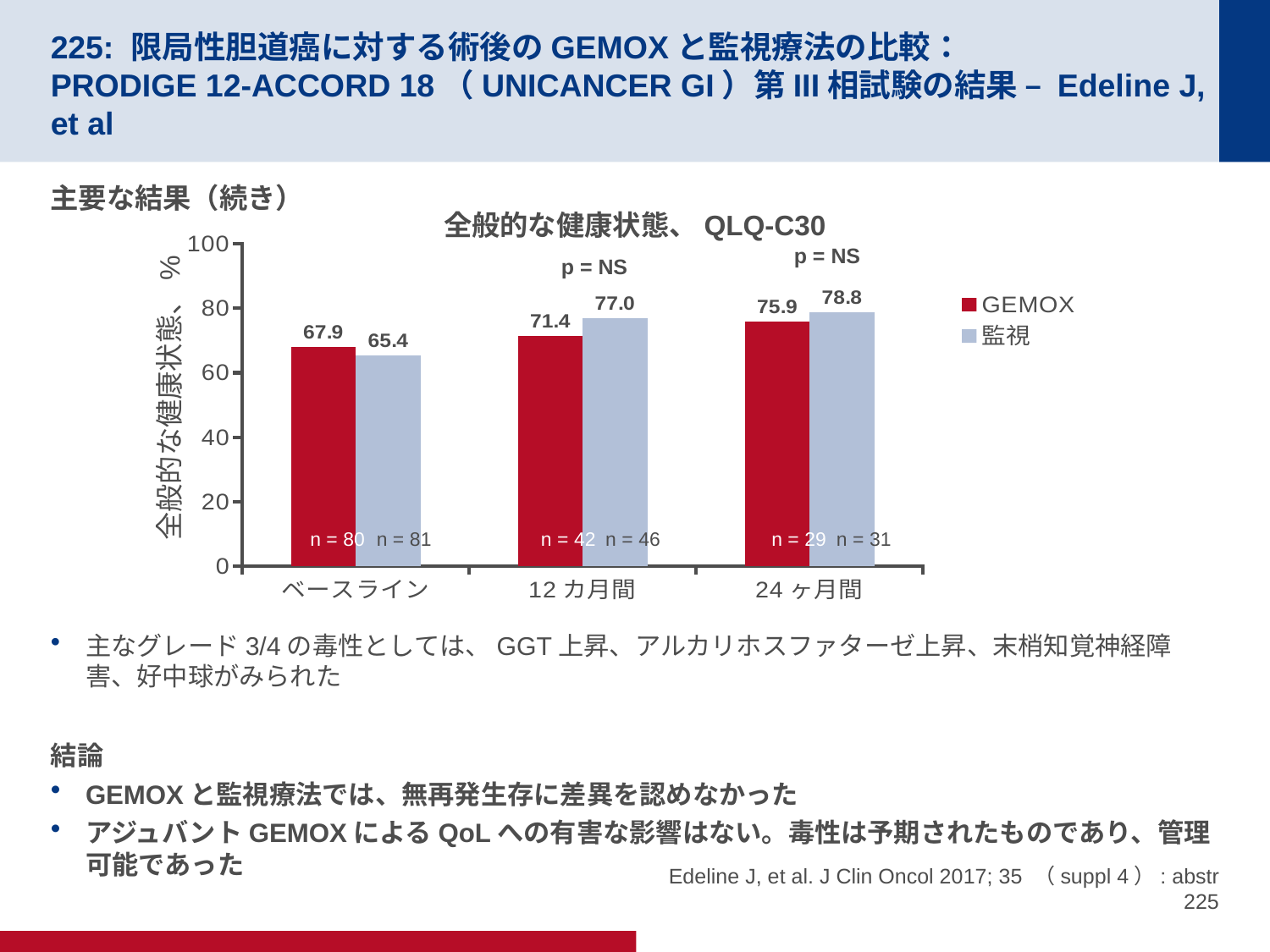
What is the GEMOX value at ベースライン? 67.9 At which time point is the GEMOX value lowest? ベースライン How many series does the legend list? 2 At which time point is the 監視 value highest? 24 ヶ月間 What is the 監視 value at 12 カ月間? 77.0 How many time points are shown on the x axis? 3 What is the 監視 value at 24 ヶ月間? 78.8 What kind of chart is shown? bar chart What is the GEMOX value at 24 ヶ月間? 75.9 At ベースライン, which series has the larger value, GEMOX or 監視? GEMOX Do the GEMOX values rise or fall from ベースライン to 24 ヶ月間? rise What is the difference between the 監視 and GEMOX values at 12 カ月間? 5.6